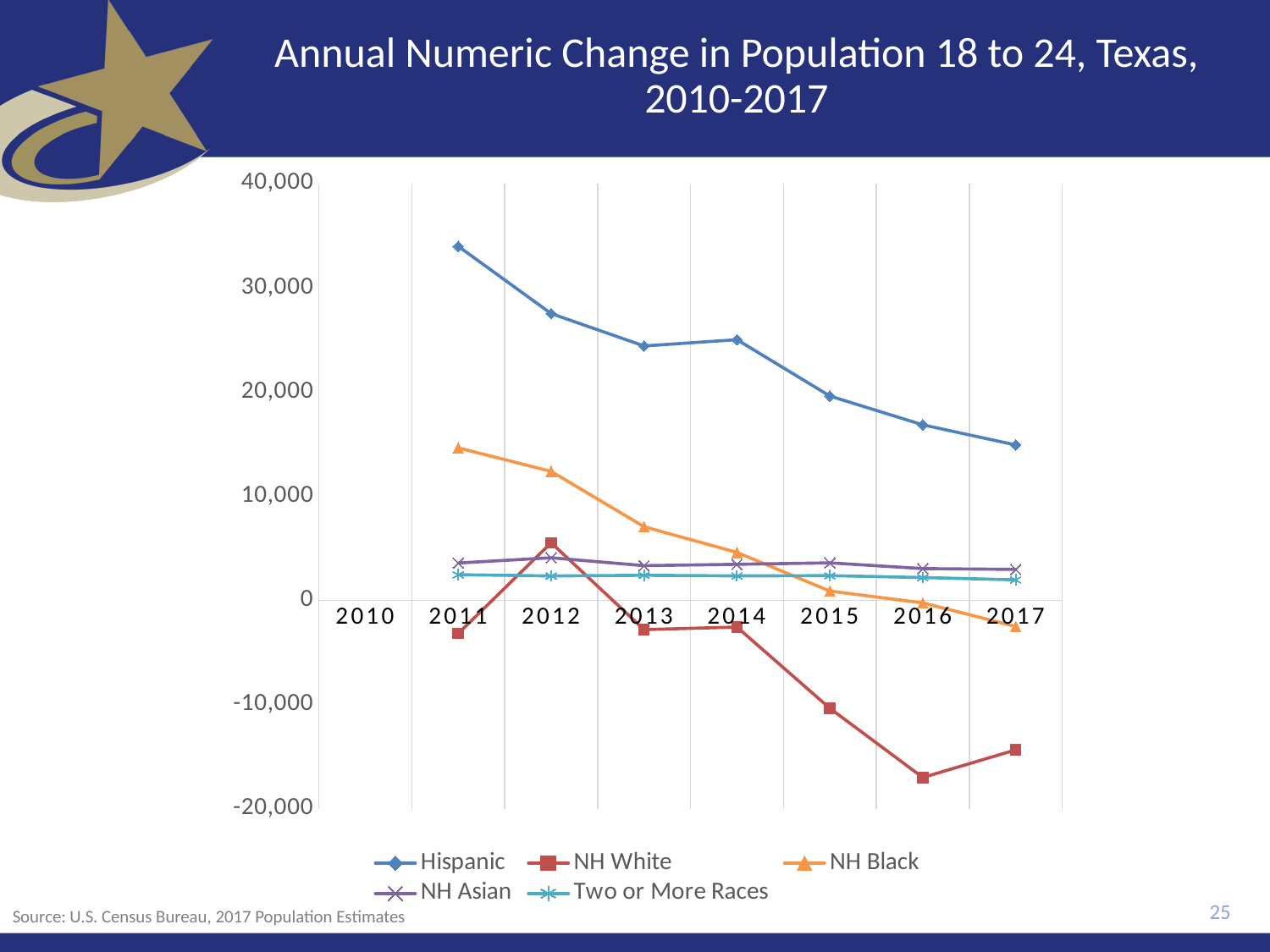
What kind of chart is shown on the slide? line chart How many series does the legend list? 5 Which is larger in 2014, the value for Hispanic or the value for NH Black? Hispanic Which series has the lowest value in 2016? NH White Which series has the highest value in 2011? Hispanic What is the title of the chart? Annual Numeric Change in Population 18 to 24, Texas, 2010-2017 Is the value for NH Black in 2017 greater or less than 0? less Is the value for Hispanic in 2011 greater or less than 30,000? greater Is the value for NH White in 2016 greater or less than -10,000? less Does the Hispanic series rise or fall from 2011 to 2017? fall